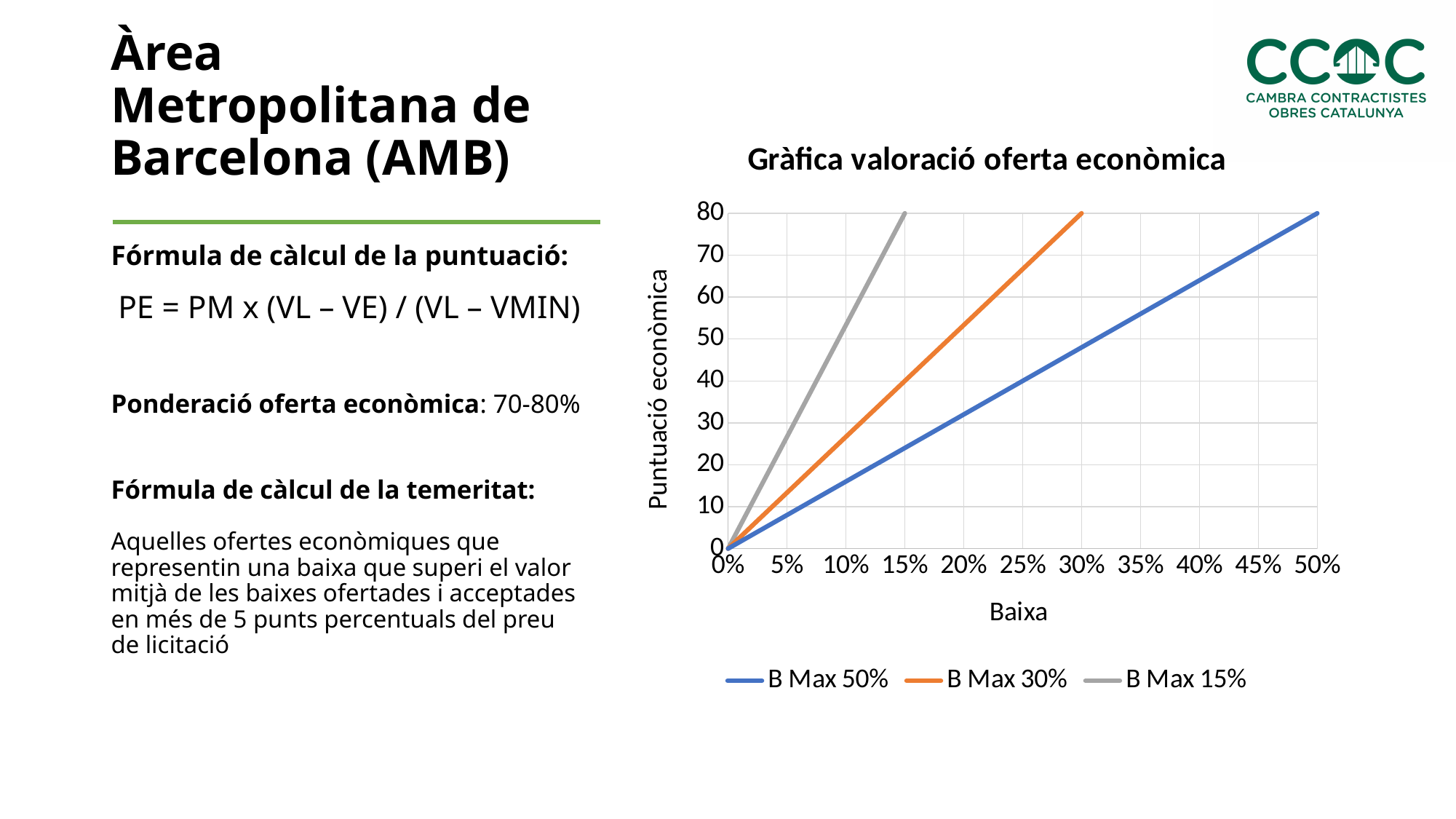
Is the Puntuació econòmica of the B Max 15% line at a Baixa of 10% greater or less than 50? greater What is the title of the chart? Gràfica valoració oferta econòmica How many series does the legend of the chart list? 3 Do the values of the B Max 50% series rise or fall as Baixa increases along the x axis? rise Which series reaches a Puntuació econòmica of 80 at the smallest Baixa? B Max 15% Is the Puntuació econòmica of the B Max 50% line at a Baixa of 20% greater or less than 40? less What Puntuació econòmica does the B Max 15% line reach at a Baixa of 15%? 80 What colour is the B Max 30% line in the chart? orange At a Baixa of 10%, which series has the higher Puntuació econòmica, B Max 15% or B Max 50%? B Max 15% What kind of chart is shown on the slide? line chart What Puntuació econòmica does the B Max 50% line reach at a Baixa of 50%? 80 What Puntuació econòmica does the B Max 30% line reach at a Baixa of 30%? 80